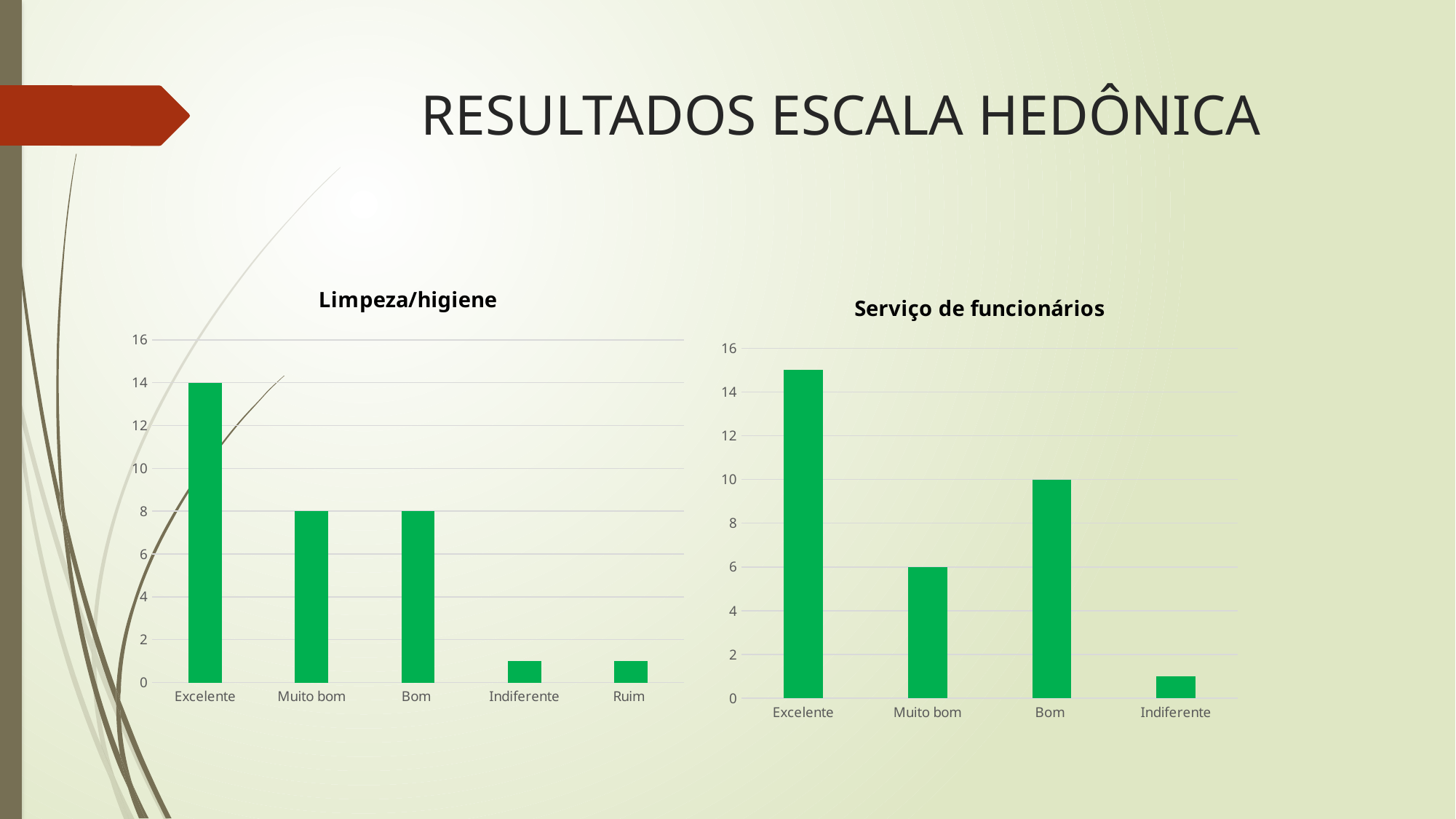
In the Limpeza/higiene chart, what is the difference between the values for Excelente and Bom? 6 In the Limpeza/higiene chart, what is the value for Muito bom? 8 What type of chart is the Serviço de funcionários chart? Bar chart In the Limpeza/higiene chart, how many categories are shown on the x axis? 5 In the Limpeza/higiene chart, is the value for Indiferente greater or less than 2? less In the Serviço de funcionários chart, is the value for Excelente greater or less than 14? greater In the Limpeza/higiene chart, what is the value for Excelente? 14 In the Serviço de funcionários chart, what is the value for Muito bom? 6 In the Serviço de funcionários chart, what is the value for Bom? 10 In the Limpeza/higiene chart, which category has the highest value? Excelente In the Serviço de funcionários chart, which category has the lowest value? Indiferente In the Serviço de funcionários chart, which is larger, the value for Bom or the value for Muito bom? Bom